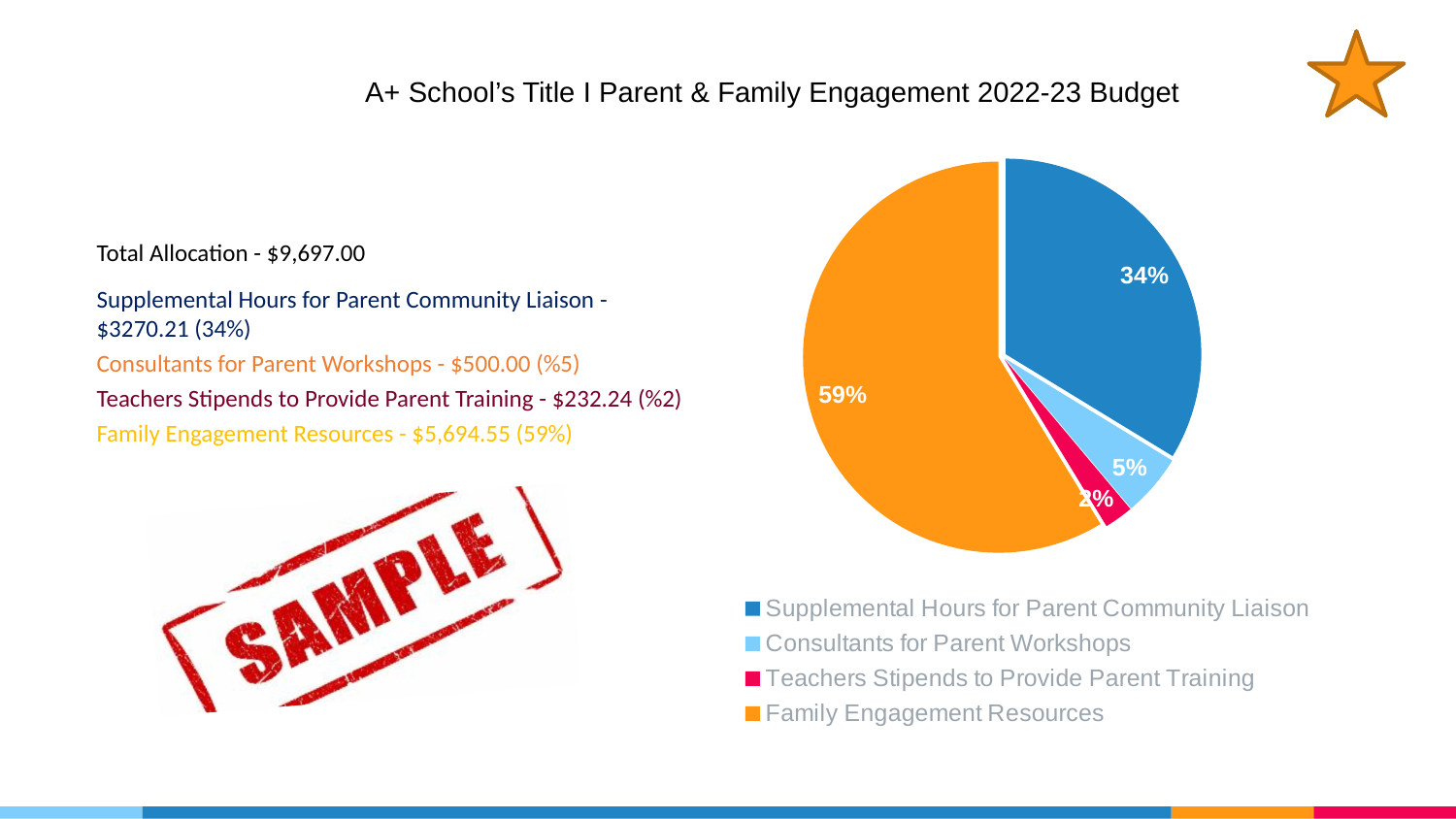
What kind of chart is shown on the slide? pie chart What colour is the slice for Family Engagement Resources? orange How many entries does the legend list? 4 How many categories does the pie chart have? 4 What share of the pie does Consultants for Parent Workshops represent? 5% What is the difference in percentage points between Family Engagement Resources and Supplemental Hours for Parent Community Liaison? 25 percentage points What share of the pie does Family Engagement Resources represent? 59% What share of the pie does Supplemental Hours for Parent Community Liaison represent? 34% Which category has the largest slice of the pie? Family Engagement Resources Which is larger: the slice for Consultants for Parent Workshops or the slice for Teachers Stipends to Provide Parent Training? Consultants for Parent Workshops Which category has the smallest slice of the pie? Teachers Stipends to Provide Parent Training